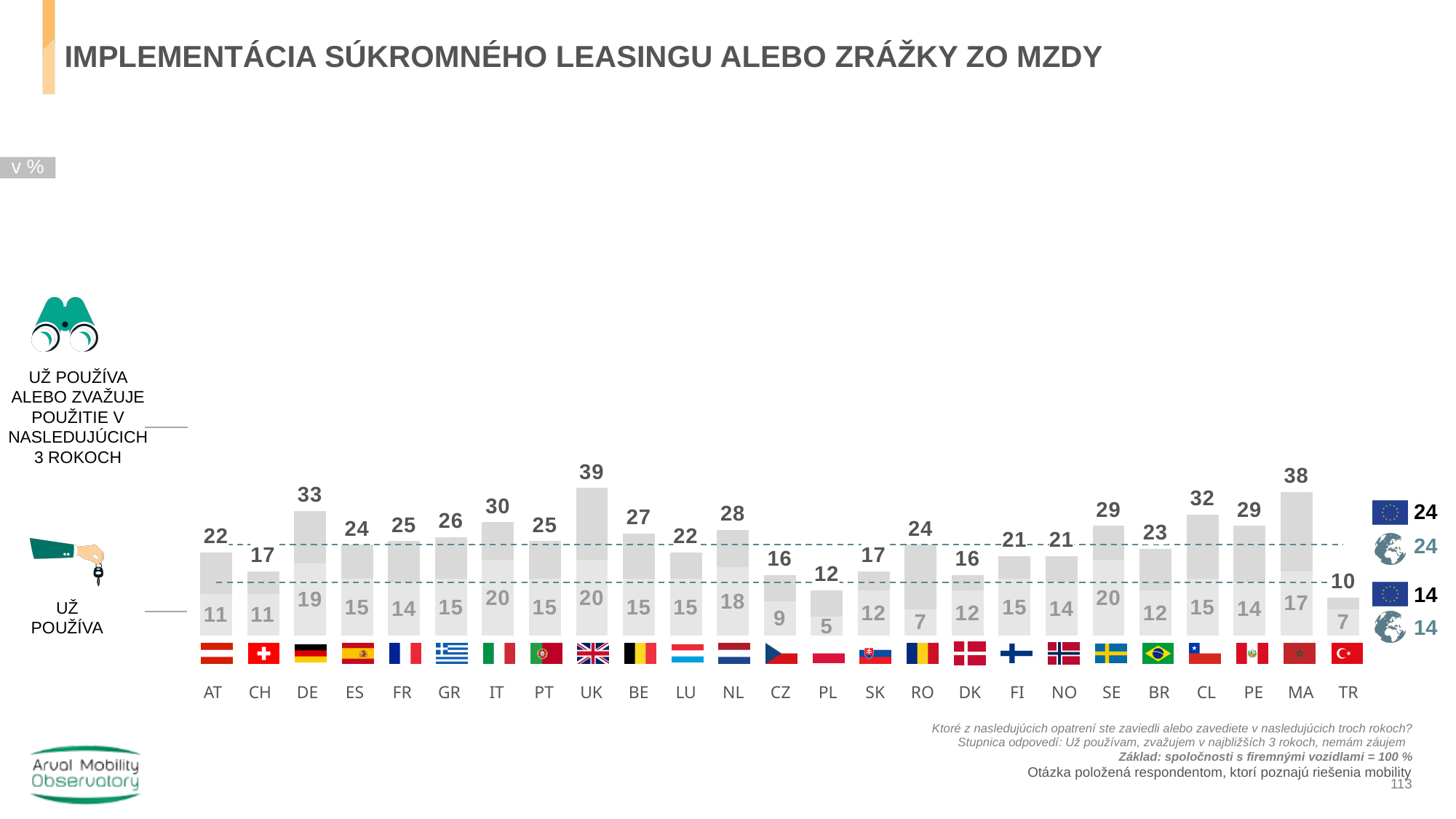
How many countries are shown on the chart? 25 What is the difference between the 'už používa alebo zvažuje' values for MA and TR? 28 Which country has the lowest 'už používa' value? PL What is the 'už používa' value for PL? 5 What is the value for UK for 'už používa alebo zvažuje použitie v nasledujúcich 3 rokoch'? 39 Which country has the lowest value for 'už používa alebo zvažuje použitie v nasledujúcich 3 rokoch'? TR What is the 'už používa' value for DE? 19 What is the EU average value shown for 'už používa'? 14 What kind of chart is shown on the slide? bar chart What unit is indicated for the values on the chart? % Which is larger, the 'už používa alebo zvažuje' value for DE or for CL? DE Which country has the highest value for 'už používa alebo zvažuje použitie v nasledujúcich 3 rokoch'? UK